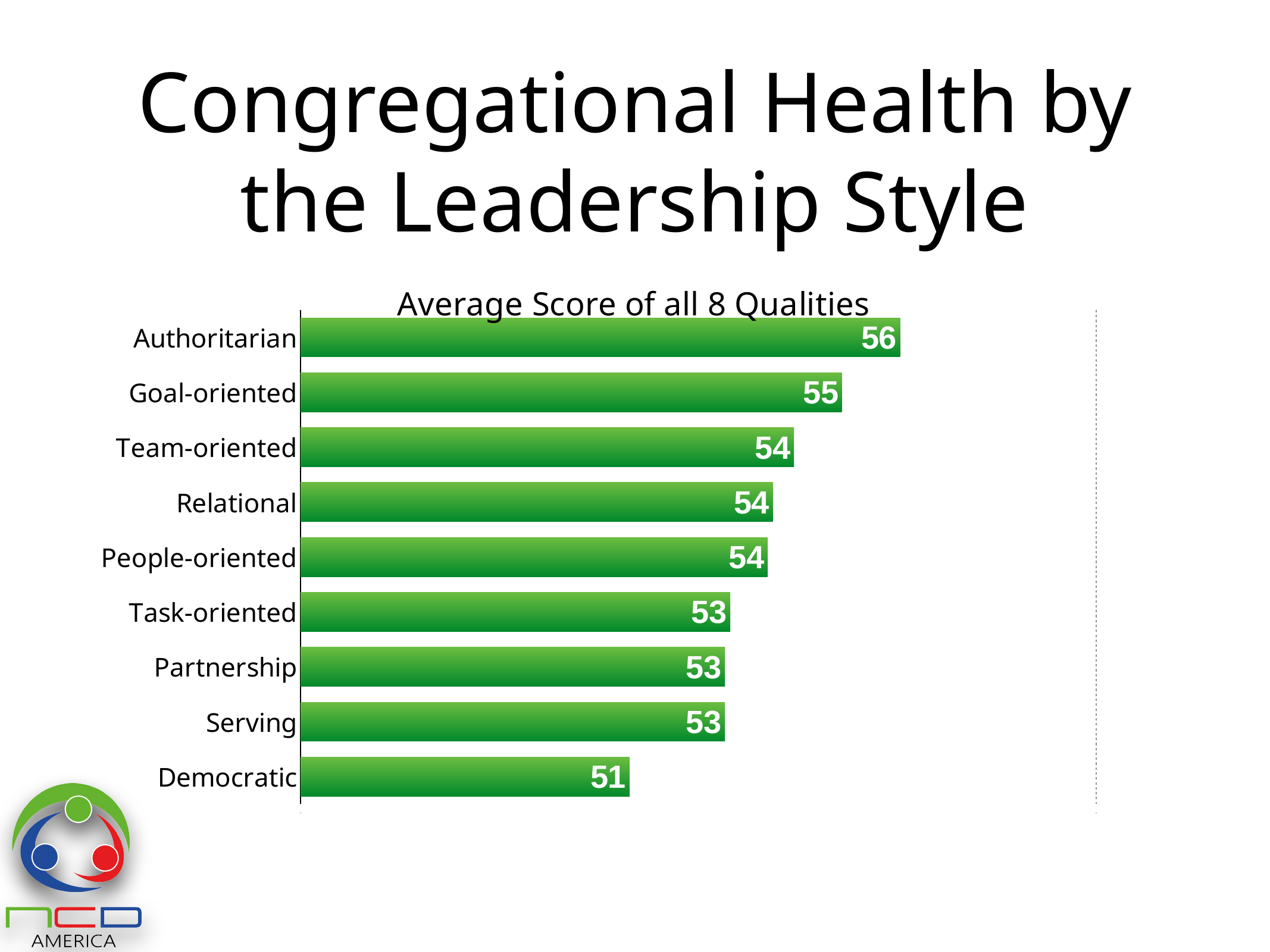
Which has a higher average score, Team-oriented or Serving? Team-oriented What is the average score for the Goal-oriented leadership style? 55 What is the average score for the Authoritarian leadership style? 56 Which leadership style has the lowest average score? Democratic How many leadership styles are shown in the chart? 9 What is the average score for the Democratic leadership style? 51 What is the average score for the Partnership leadership style? 53 What is the title of the chart? Average Score of all 8 Qualities Which leadership style has the highest average score? Authoritarian What kind of chart is shown on the slide? Bar chart What is the difference between the average scores of Authoritarian and Democratic? 5 What is the difference between the average scores of Goal-oriented and Task-oriented? 2